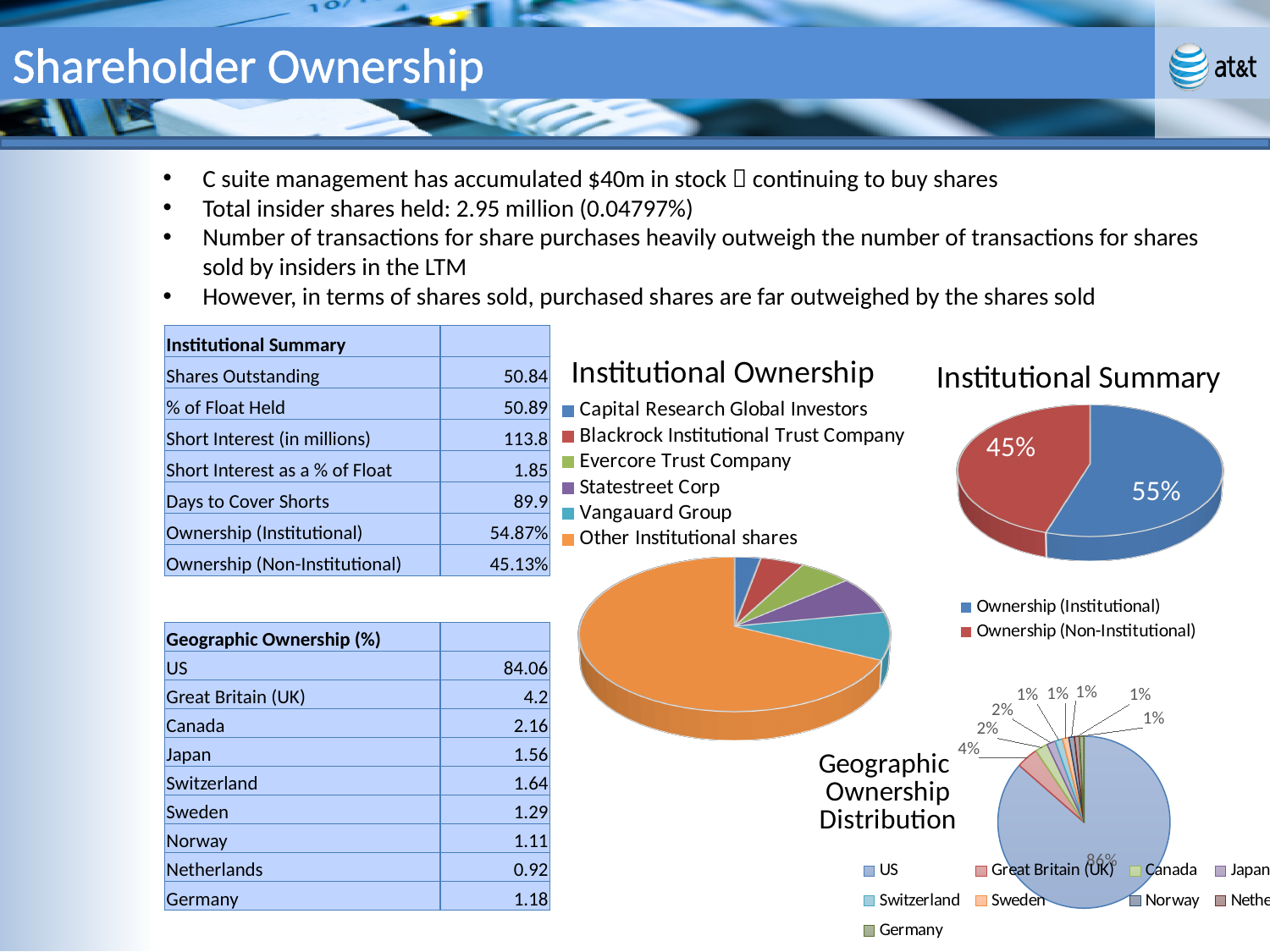
What kind of chart is the Institutional Summary chart? Pie chart How many entries does the legend of the Institutional Summary chart list? 2 In the Geographic Ownership Distribution pie chart, which country has the largest slice? US How many entries does the legend of the Institutional Ownership chart list? 6 In the Institutional Summary pie chart, what is the difference between the Institutional and Non-Institutional shares? 10 percentage points In the Institutional Summary pie chart, which slice is larger? Ownership (Institutional) In the Institutional Summary pie chart, what share is shown for Ownership (Non-Institutional)? 45% In the Institutional Summary pie chart, what share is shown for Ownership (Institutional)? 55% How many charts are shown on the slide? 3 What kind of chart is the Institutional Ownership chart? Pie chart How many countries does the legend of the Geographic Ownership Distribution chart list? 9 In the Institutional Ownership pie chart, which category has the largest slice? Other Institutional shares